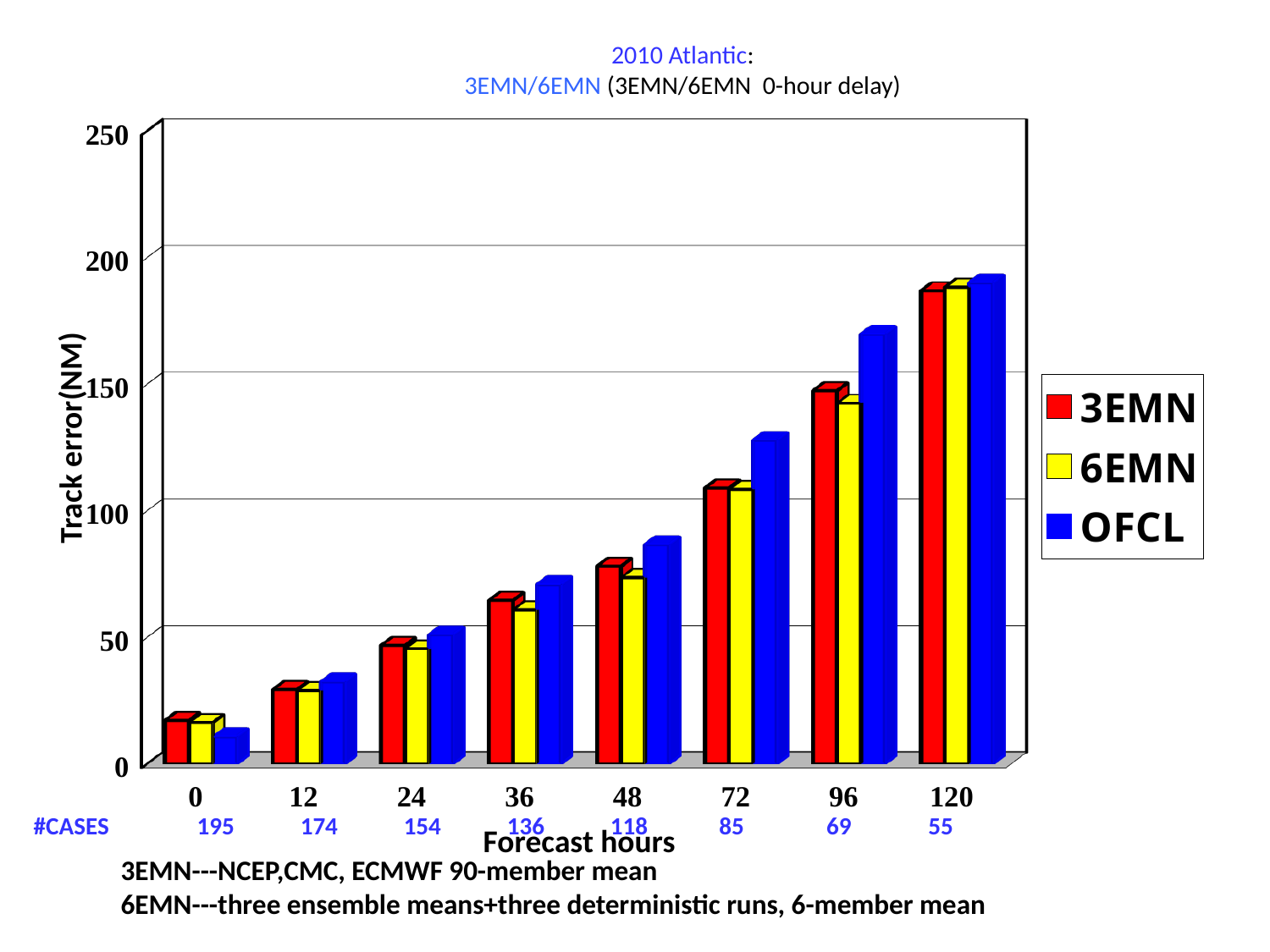
At 0 forecast hours, which is larger, the 3EMN value or the OFCL value? 3EMN At which forecast hour is the OFCL track error highest? 120 Is the OFCL value at 96 forecast hours greater or less than 150? greater Do the track error values rise or fall as forecast hours increase? rise What kind of chart is shown on the slide? bar chart Is the 3EMN value at 120 forecast hours greater or less than 200? less What is the y-axis label of the chart? Track error(NM) How many forecast-hour categories are shown on the x axis? 8 At which forecast hour is the 3EMN track error lowest? 0 Is the OFCL value at 0 forecast hours greater or less than 50? less How many series does the legend list? 3 At 96 forecast hours, which is larger, the 3EMN value or the OFCL value? OFCL